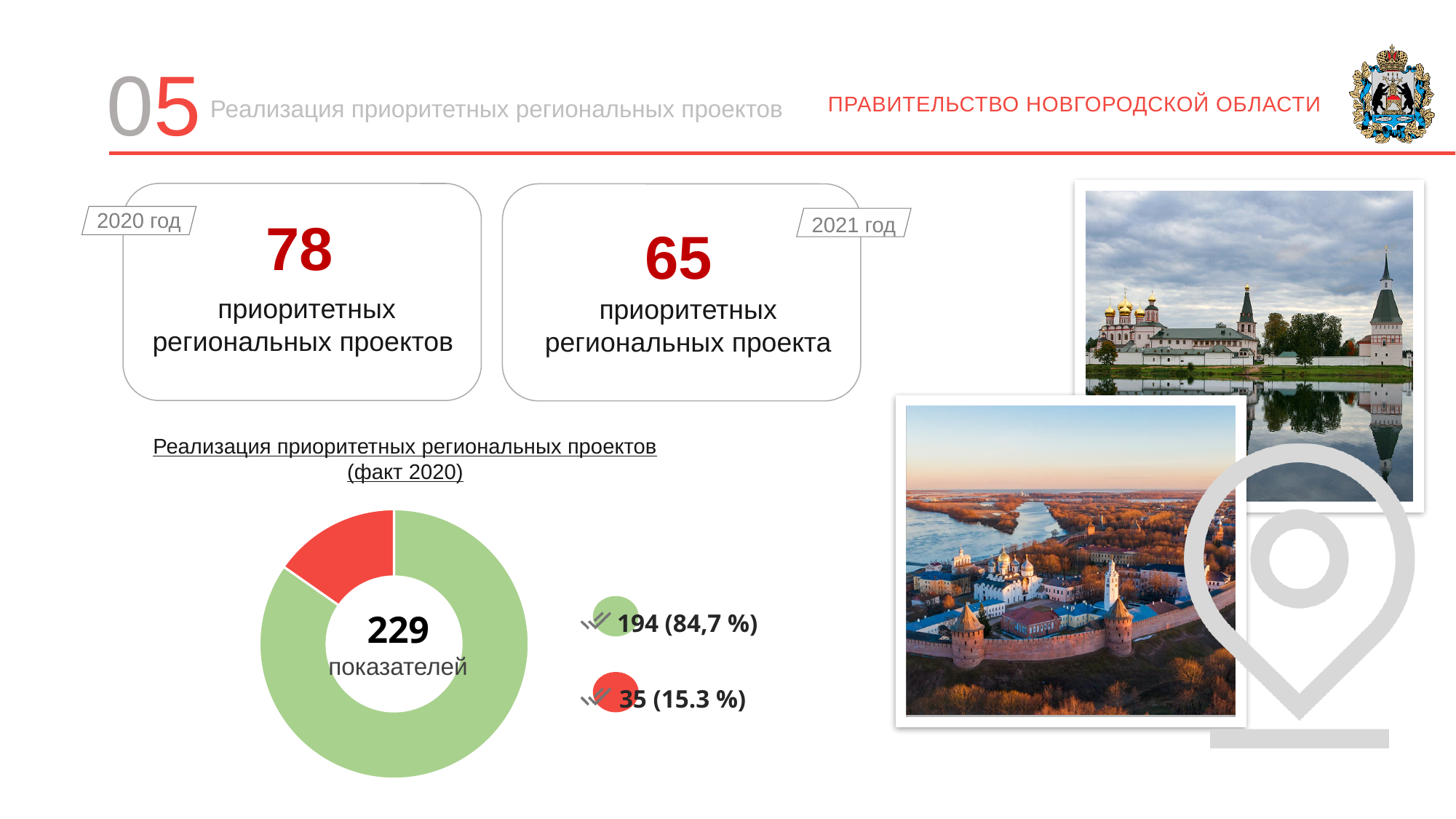
What kind of chart is shown on the slide? Donut (pie) chart What value is shown for the green segment of the donut chart? 194 (84,7 %) What share of the donut chart does the red segment represent? 15.3 % Which segment of the donut chart is larger, the green one or the red one? The green one Which segment of the donut chart is the smallest? The red segment (35) What value is shown for the red segment of the donut chart? 35 (15.3 %) How many segments does the donut chart have? 2 What is the sum of the two segment values in the donut chart? 229 What share of the donut chart does the green segment represent? 84,7 % What is the title of the chart on the slide? Реализация приоритетных региональных проектов (факт 2020) What is the difference between the green segment value and the red segment value in the donut chart? 159 What total number is shown in the centre of the donut chart? 229 показателей